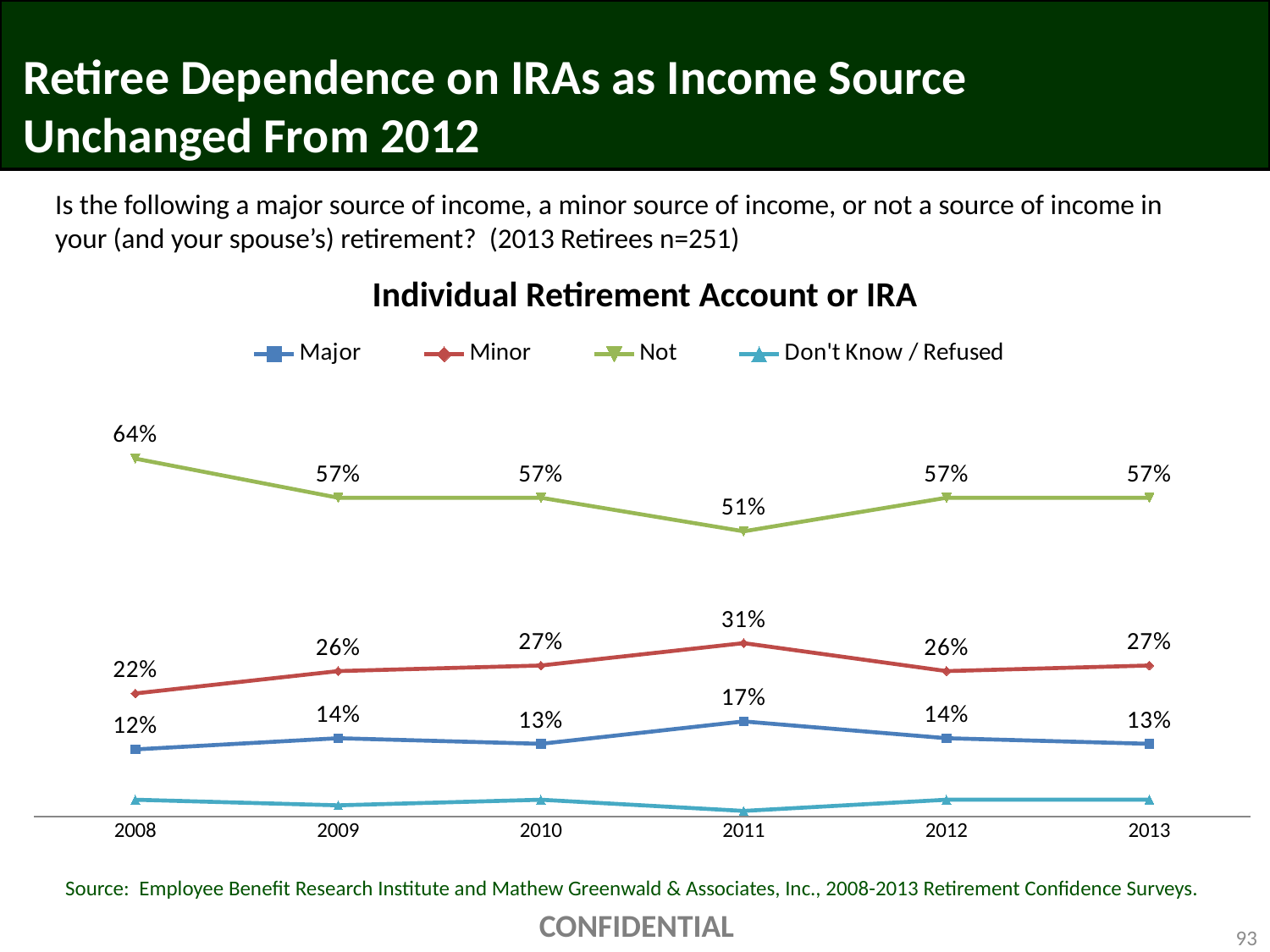
What is the difference between the Not value in 2008 and the Not value in 2011? 13% What is the value for the Major series in 2013? 13% How many series does the legend list? 4 What is the value for the Not series in 2008? 64% What is the value for the Minor series in 2011? 31% Does the Not series rise or fall from 2008 to 2009? fall How many years are plotted along the x axis? 6 Which is larger in 2012, the Minor value or the Major value? Minor In which year is the Not series at its lowest? 2011 What type of chart is shown on the slide? line chart What is the title of the chart? Individual Retirement Account or IRA In which year is the Major series at its highest? 2011